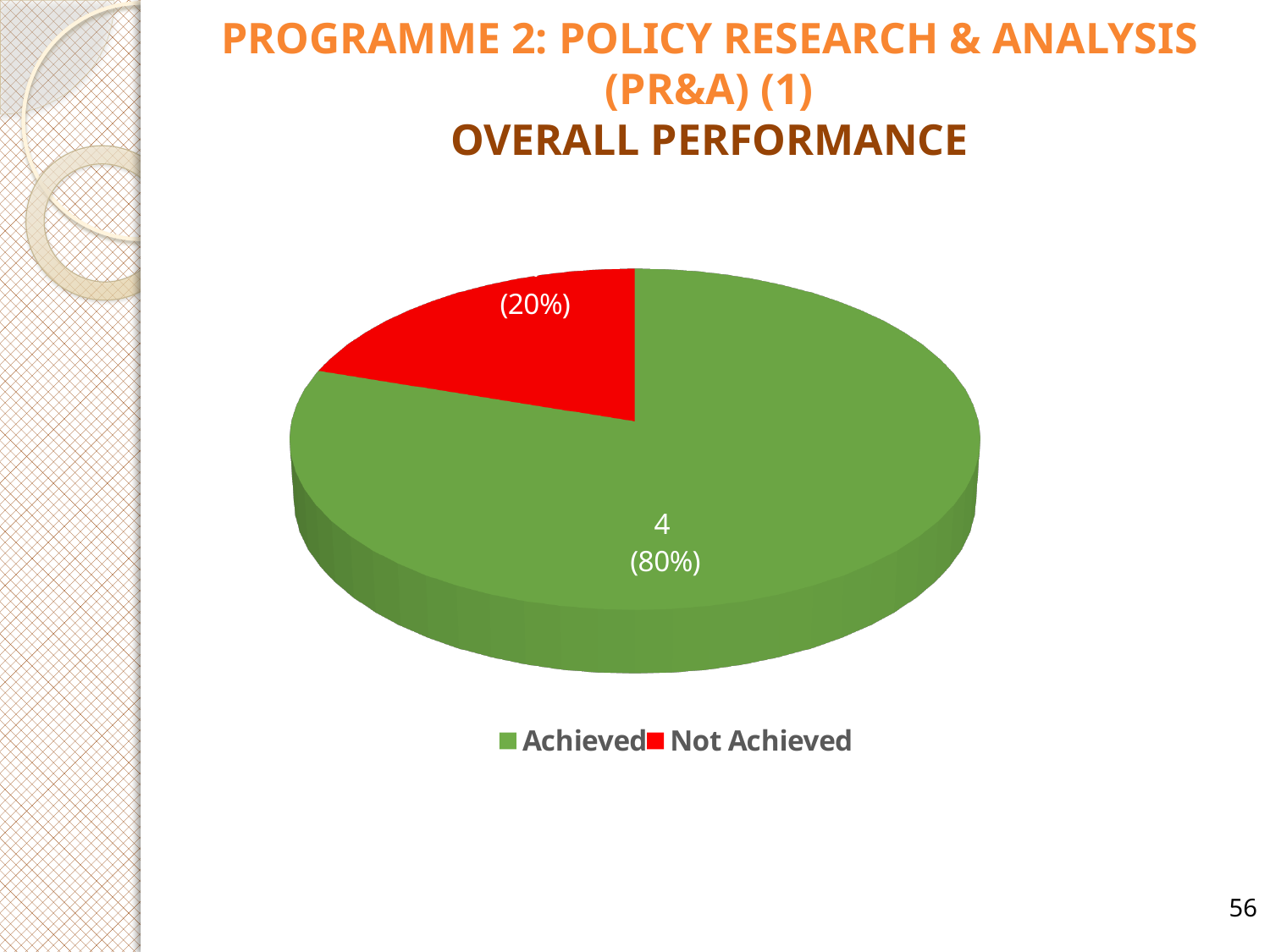
What colour is used for the Achieved slice? green What are the two entries listed in the legend? Achieved and Not Achieved What is the number shown on the Achieved slice? 4 What kind of chart is shown on the slide? pie chart What share of the pie does the Not Achieved slice represent? 20% Which category has the smallest slice of the pie? Not Achieved Which slice is larger, Achieved or Not Achieved? Achieved What share of the pie does the Achieved slice represent? 80% How many slices does the pie chart have? 2 By how many percentage points does the Achieved share exceed the Not Achieved share? 60 percentage points How many entries does the legend list? 2 Which category has the largest slice of the pie? Achieved